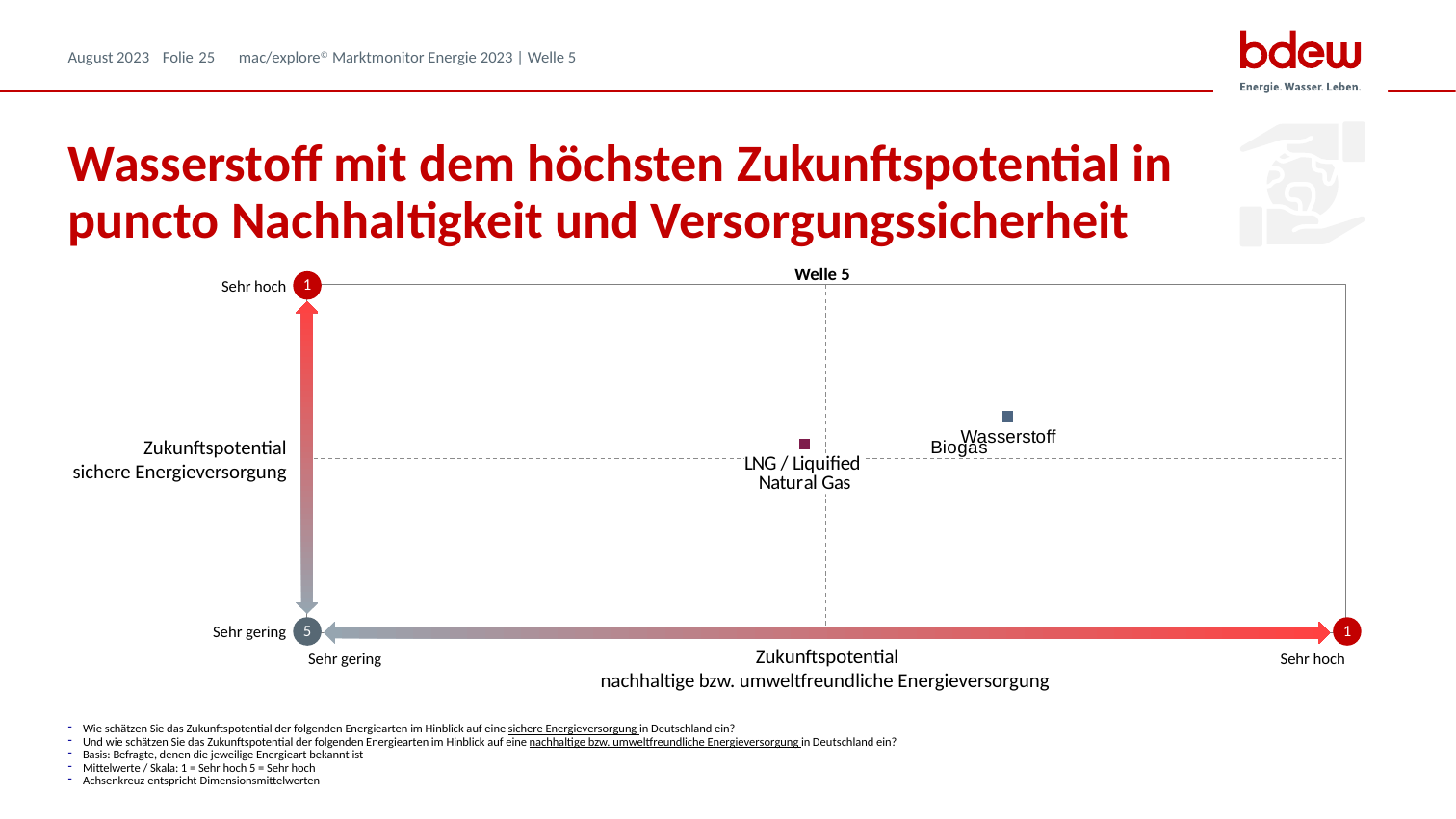
What is the title printed above the chart? Welle 5 How many energy types are plotted as labelled points in the chart? 3 Which energy type is plotted highest on the vertical axis (Zukunftspotential sichere Energieversorgung)? Wasserstoff Is the Wasserstoff point above or below the dashed horizontal line marking the dimension mean? above Which energy type is plotted furthest to the left on the horizontal axis? LNG / Liquified Natural Gas Which is plotted further towards 'Sehr hoch' on the horizontal axis: LNG / Liquified Natural Gas or Wasserstoff? Wasserstoff Which energy type is plotted furthest to the right on the horizontal axis (Zukunftspotential nachhaltige bzw. umweltfreundliche Energieversorgung)? Wasserstoff What kind of chart is shown on the slide? scatter chart What label is shown at the top end of the vertical axis, next to the value 1? Sehr hoch Which is plotted lower on the vertical axis: LNG / Liquified Natural Gas or Wasserstoff? LNG / Liquified Natural Gas